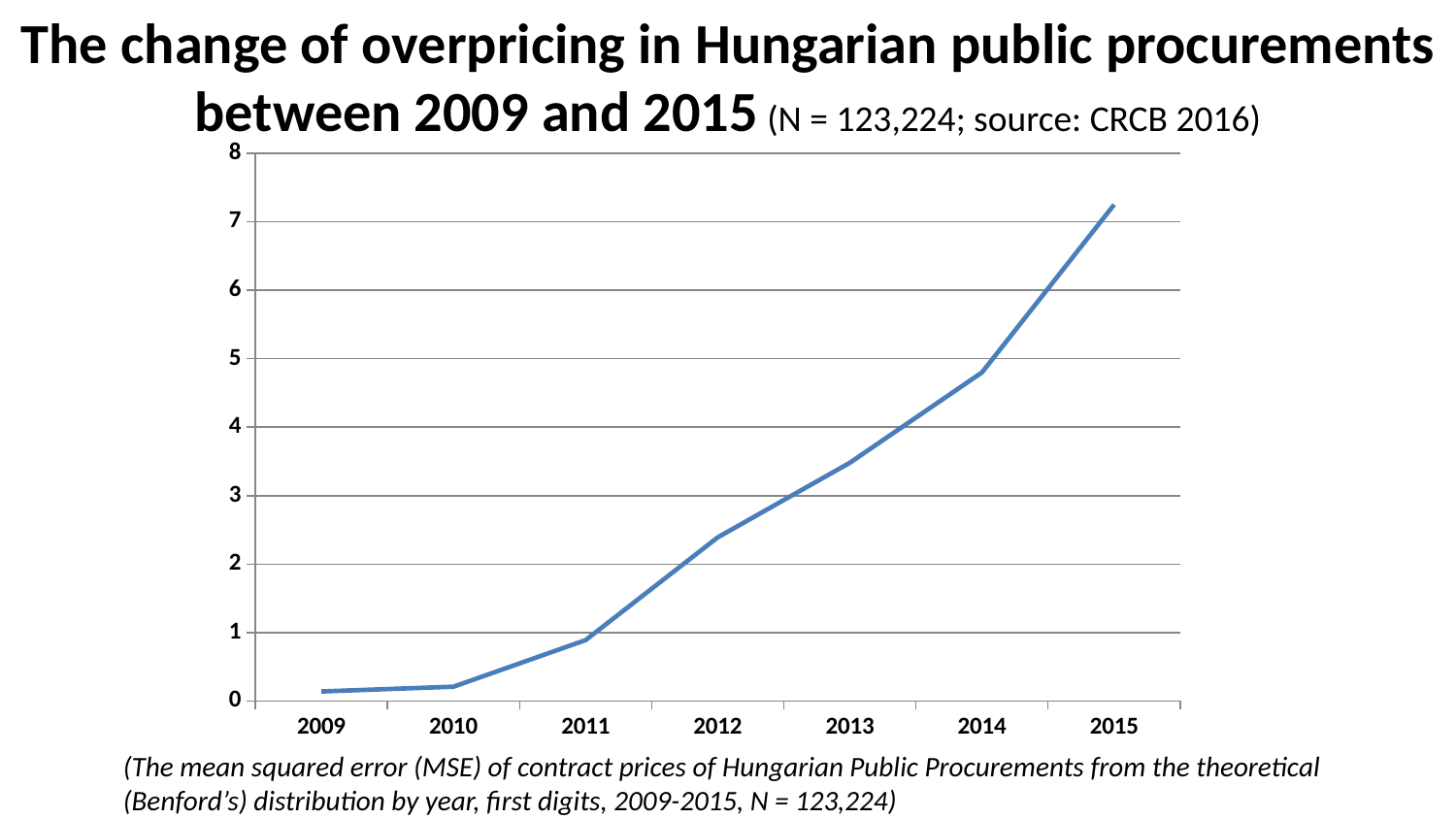
What is the highest value shown on the y axis? 8 Is the value for 2011 greater or less than 1? less Which year has the highest value? 2015 What is the sample size (N) given in the chart title? 123,224 What kind of chart is shown on the slide? line chart Is the value for 2012 greater or less than 2? greater Which year has the lowest value? 2009 Is the value for 2014 greater or less than 5? less Do the values rise or fall from 2009 to 2015? rise How many years are plotted on the x axis? 7 Which is larger, the value for 2013 or the value for 2011? 2013